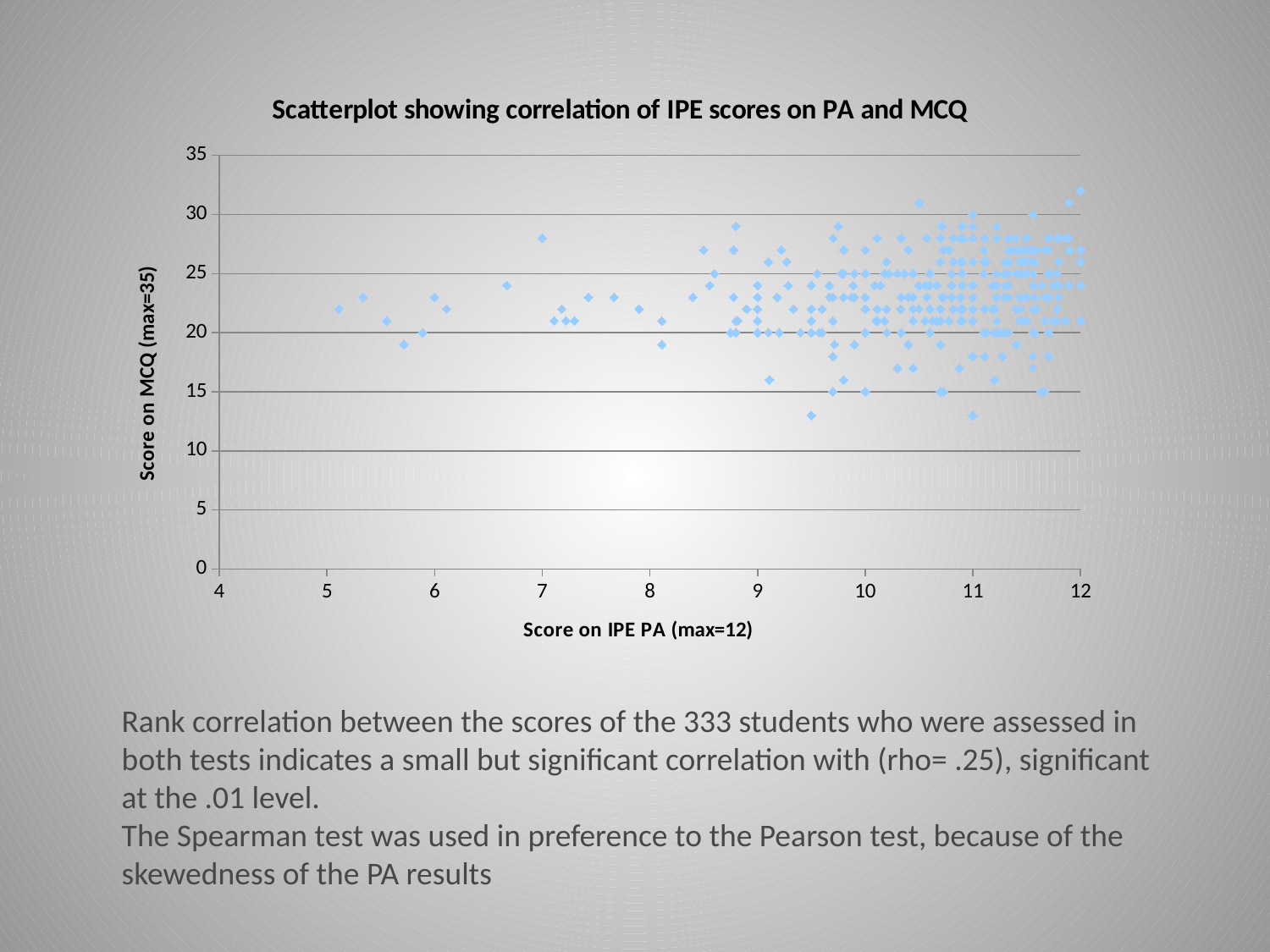
Is the lowest MCQ score plotted greater or less than 15? less What is the title of the chart? Scatterplot showing correlation of IPE scores on PA and MCQ Do the MCQ scores tend to rise or fall as the IPE PA score increases along the x axis? Rise What kind of chart is shown on the slide? Scatter plot Is the highest MCQ score plotted greater or less than 30? greater Is the lowest IPE PA score plotted greater or less than 6? less How many students' scores are plotted in the scatter plot, according to the slide? 333 What is the label of the vertical axis of the chart? Score on MCQ (max=35)